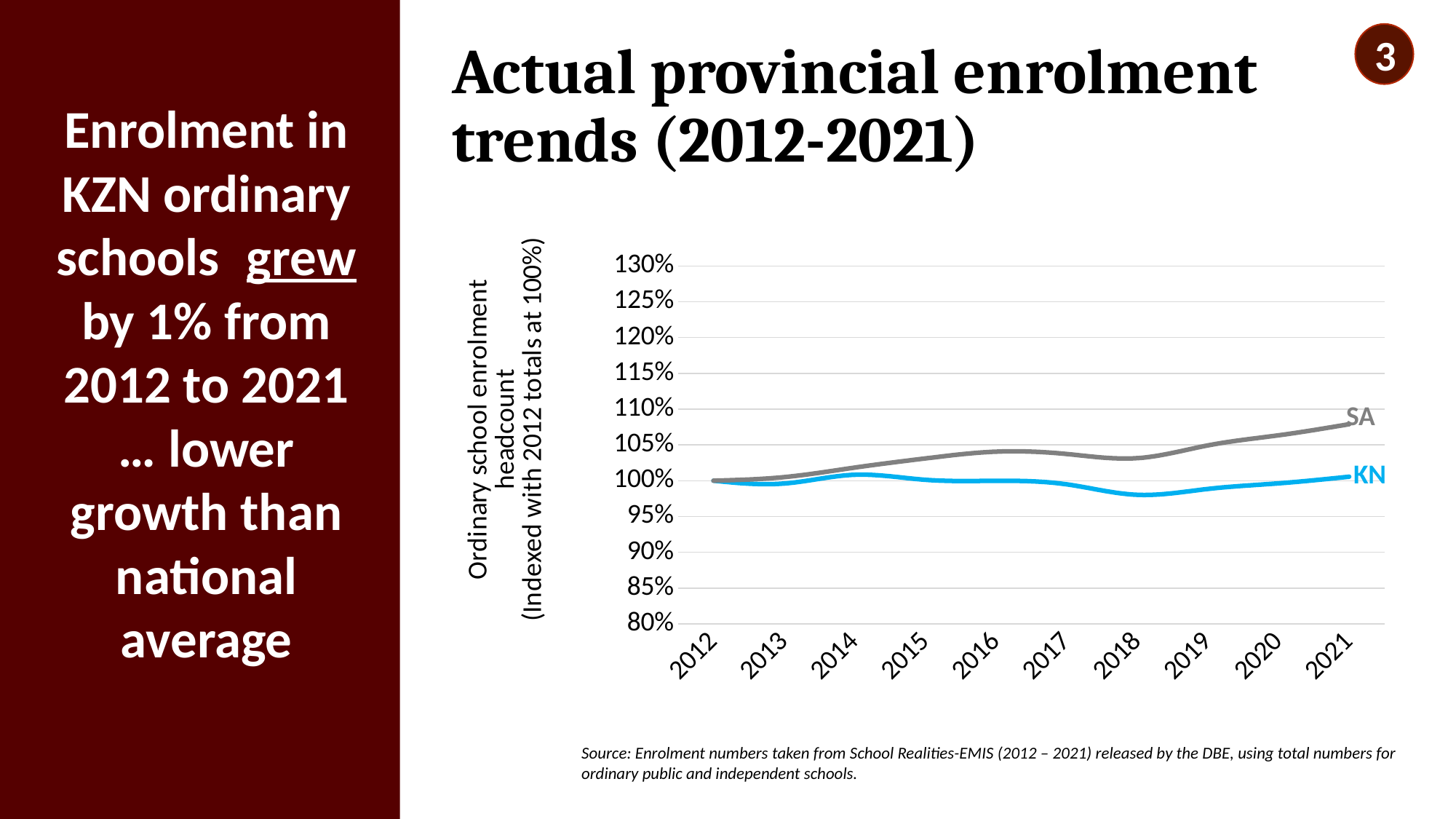
Which series has the higher value in 2021, SA or KN? SA What is the value for SA in 2012? 100% What kind of chart is shown on the slide? line chart Is the value for KN in 2018 greater or less than 100%? less Is the value for SA in 2021 greater or less than 105%? greater What is the value for KN in 2012? 100% How many series are plotted on the chart? 2 In which year does the KN series reach its lowest value? 2018 How many years are shown on the x axis of the chart? 10 Is the value for SA in 2021 greater or less than 110%? less Does the SA series rise or fall overall from 2012 to 2021? rise In which year does the SA series reach its highest value? 2021